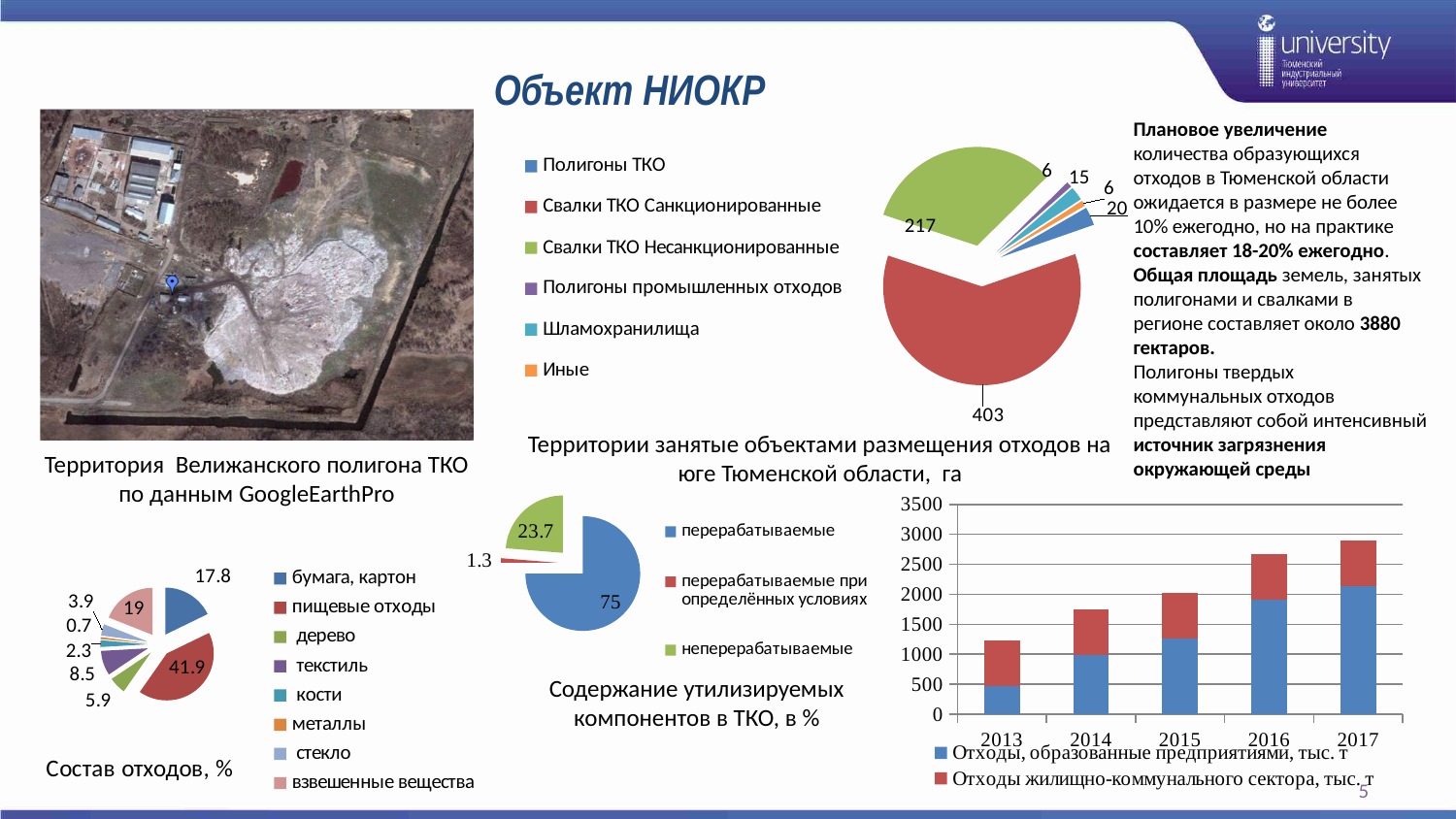
In the pie chart 'Территории занятые объектами размещения отходов на юге Тюменской области, га', what is the value for Свалки ТКО Санкционированные? 403 In the pie chart 'Содержание утилизируемых компонентов в ТКО, в %', what is the value for неперерабатываемые? 23.7 In the pie chart 'Содержание утилизируемых компонентов в ТКО, в %', what share of the pie is перерабатываемые? 75% In the pie chart 'Состав отходов, %', which category has the largest share? пищевые отходы In the pie chart 'Состав отходов, %', which is larger: бумага, картон or взвешенные вещества? взвешенные вещества In the pie chart 'Территории занятые объектами размещения отходов на юге Тюменской области, га', what is the difference between Свалки ТКО Санкционированные and Свалки ТКО Несанкционированные? 186 In the pie chart 'Состав отходов, %', which category has the smallest share? металлы In the pie chart 'Состав отходов, %', what is the value for пищевые отходы? 41.9 In the pie chart 'Территории занятые объектами размещения отходов на юге Тюменской области, га', what is the value for Шламохранилища? 15 In the stacked bar chart at the bottom right, how many series does the legend list? 2 In the stacked bar chart at the bottom right, do the total values rise or fall from 2013 to 2017? rise In the stacked bar chart at the bottom right, is the total for 2017 greater or less than 2500? greater